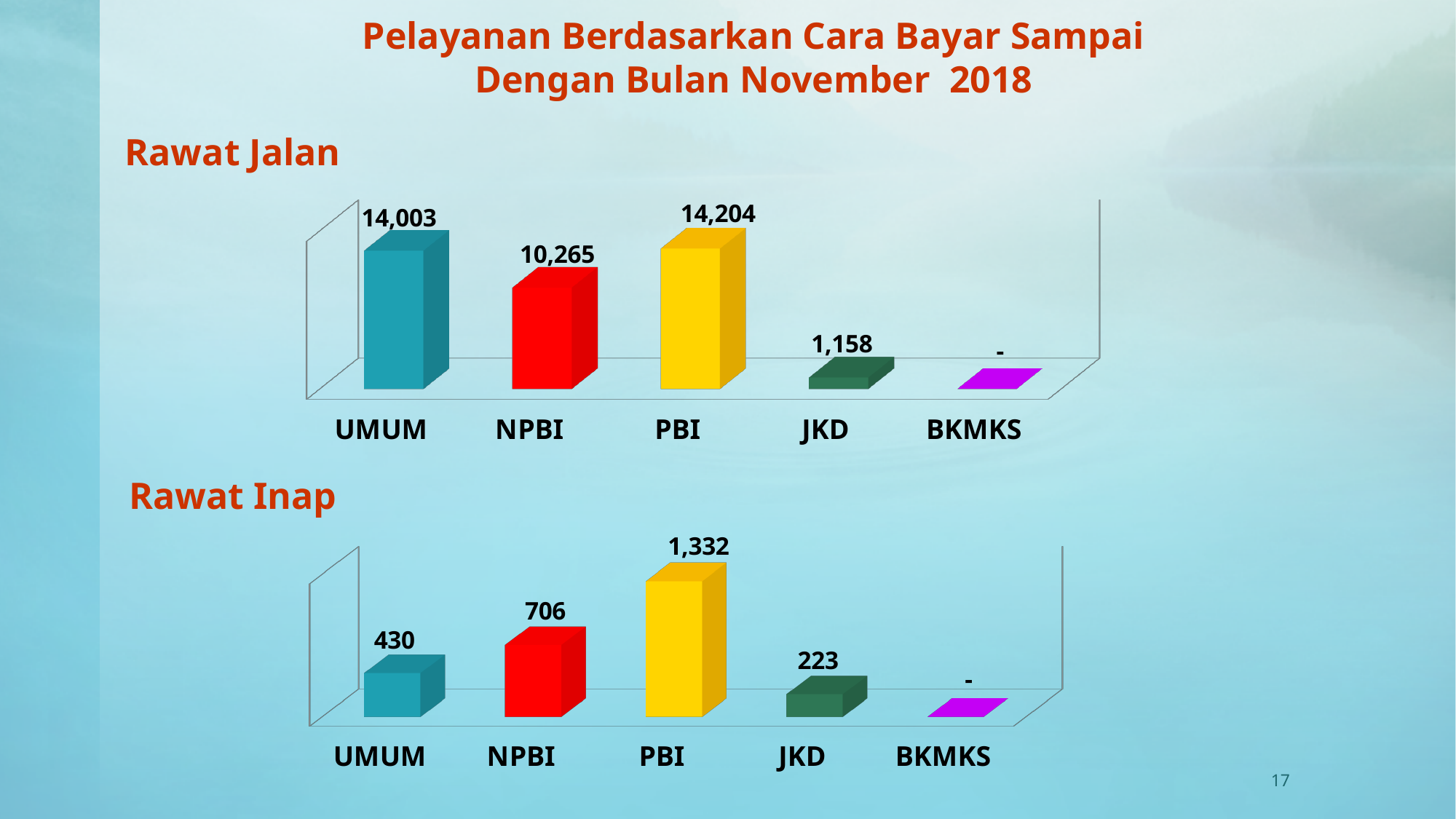
In the Rawat Inap chart, what is the difference between the UMUM and JKD values? 207 In the Rawat Jalan chart, what is the value for UMUM? 14,003 In the Rawat Jalan chart, which category has the highest value? PBI In the Rawat Jalan chart, which is larger, UMUM or NPBI? UMUM In the Rawat Jalan chart, what is the value for JKD? 1,158 In the Rawat Jalan chart, what is the difference between the PBI and NPBI values? 3,939 What type of chart is the Rawat Jalan chart? Bar chart In the Rawat Inap chart, which category has the lowest value among those with a numeric label? JKD In the Rawat Inap chart, what is the value for PBI? 1,332 How many categories are shown on the x axis of the Rawat Inap chart? 5 In the Rawat Jalan chart, what label is shown above the BKMKS bar? - In the Rawat Inap chart, what is the value for NPBI? 706